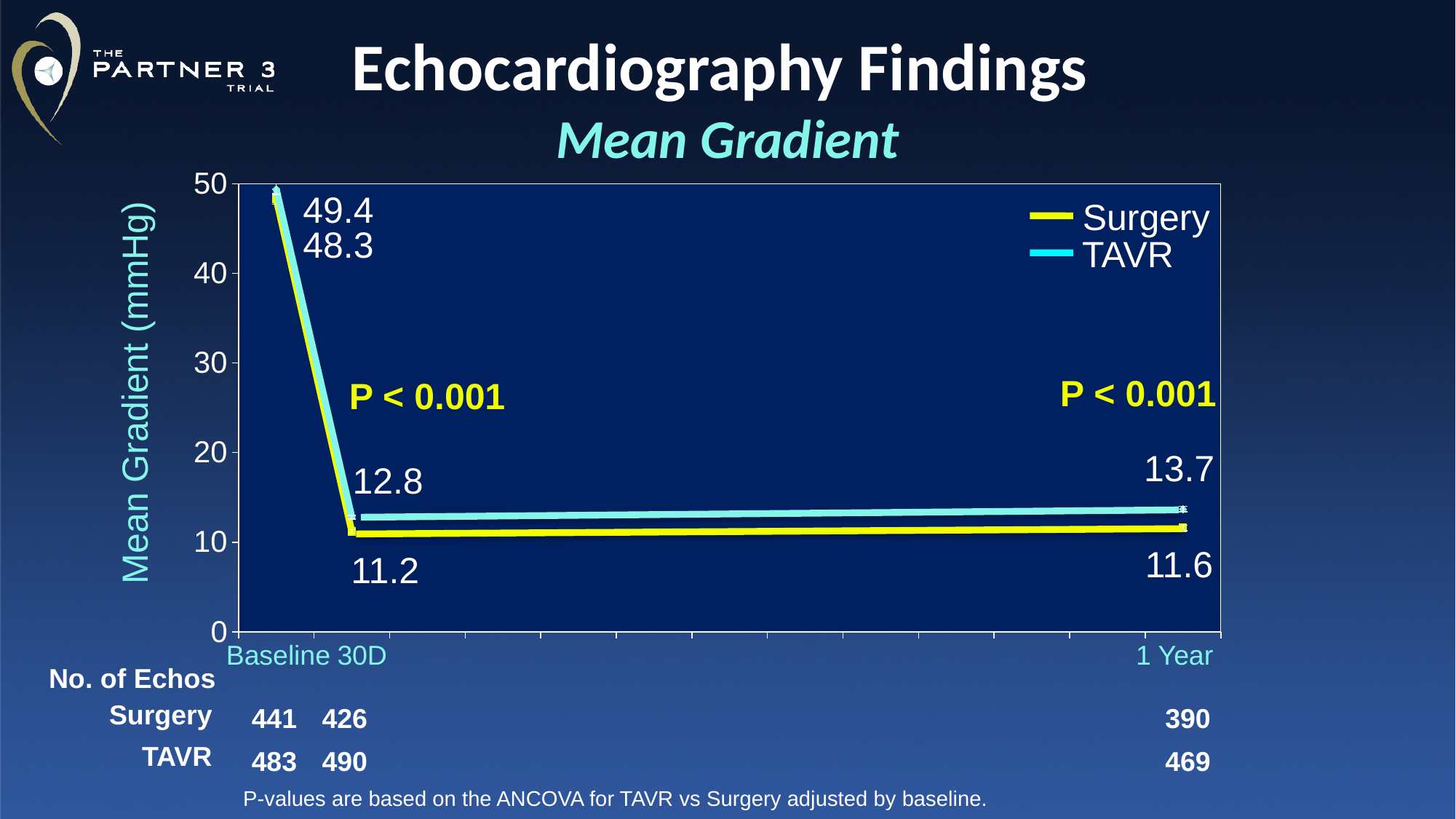
What is the difference between the TAVR and Surgery mean gradients at 1 Year? 2.1 Does the Surgery mean gradient rise or fall from Baseline to 30D? fall How many time points are plotted on the x axis? 3 What is the mean gradient for Surgery at 1 Year? 11.6 At 1 Year, which group has the higher mean gradient, Surgery or TAVR? TAVR How many series does the legend list? 2 What is the mean gradient for TAVR at 1 Year? 13.7 What kind of chart is shown on the slide? line chart What is the label on the y axis of the chart? Mean Gradient (mmHg) What is the mean gradient for Surgery at 30D? 11.2 What is the mean gradient for TAVR at 30D? 12.8 What is the difference between the TAVR and Surgery mean gradients at 30D? 1.6